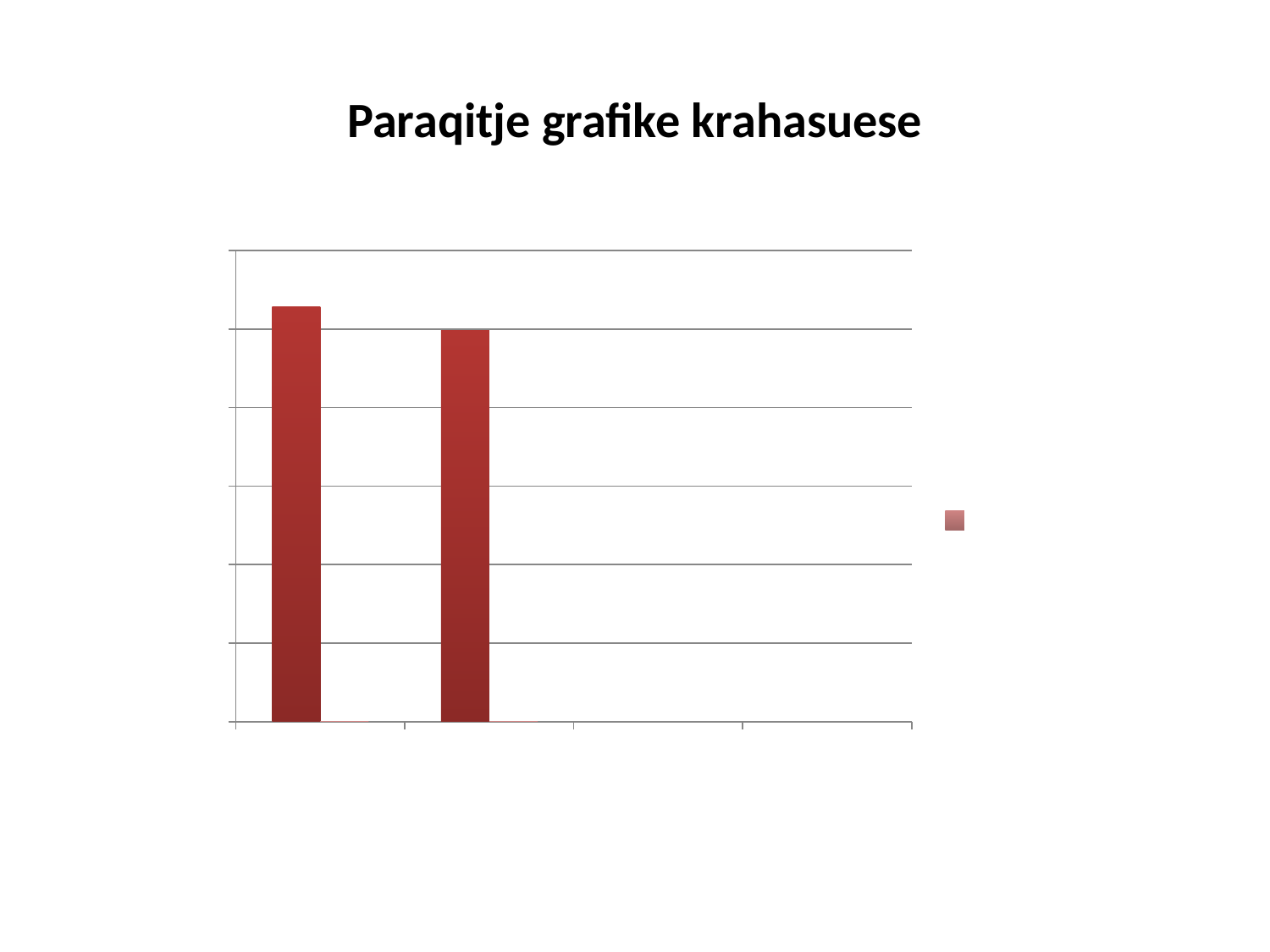
Which bar has the lowest value in the chart? the right bar What kind of chart is shown on the slide? bar chart How many bars are plotted in the chart? 2 How many series does the legend list? 1 What colour are the bars in the chart? red Which bar has the highest value in the chart? the left bar Which bar is taller, the left bar or the right bar? the left bar Do the bar values rise or fall from left to right? fall What is the title of the chart on the slide? Paraqitje grafike krahasuese